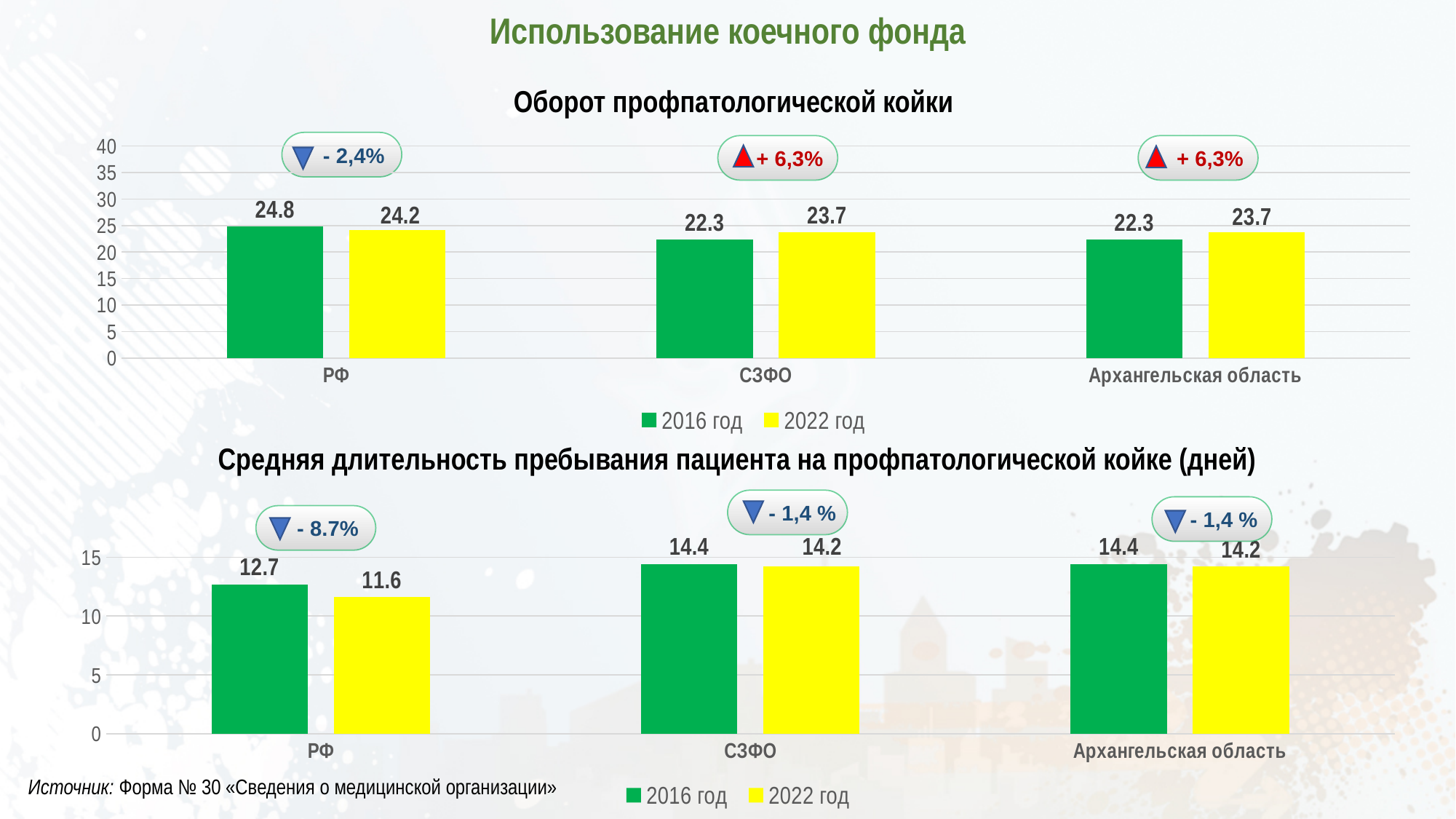
In the chart 'Оборот профпатологической койки', what is the value for СЗФО in 2022 год? 23.7 In the chart 'Средняя длительность пребывания пациента на профпатологической койке (дней)', what is the value for СЗФО in 2016 год? 14.4 In the chart 'Оборот профпатологической койки', what is the difference between the 2016 год and 2022 год values for РФ? 0.6 In the chart 'Оборот профпатологической койки', is the 2022 год value for Архангельская область larger or smaller than the 2016 год value? larger In the chart 'Оборот профпатологической койки', which category has the highest value for 2016 год? РФ In the chart 'Оборот профпатологической койки', how many series does the legend list? 2 What kind of chart is 'Оборот профпатологической койки'? bar chart In the chart 'Средняя длительность пребывания пациента на профпатологической койке (дней)', what is the value for РФ in 2022 год? 11.6 In the chart 'Средняя длительность пребывания пациента на профпатологической койке (дней)', what is the difference between the 2016 год and 2022 год values for РФ? 1.1 In the chart 'Оборот профпатологической койки', what is the value for РФ in 2016 год? 24.8 How many categories are shown on the x axis of the chart 'Средняя длительность пребывания пациента на профпатологической койке (дней)'? 3 In the chart 'Средняя длительность пребывания пациента на профпатологической койке (дней)', which category has the lowest value for 2022 год? РФ